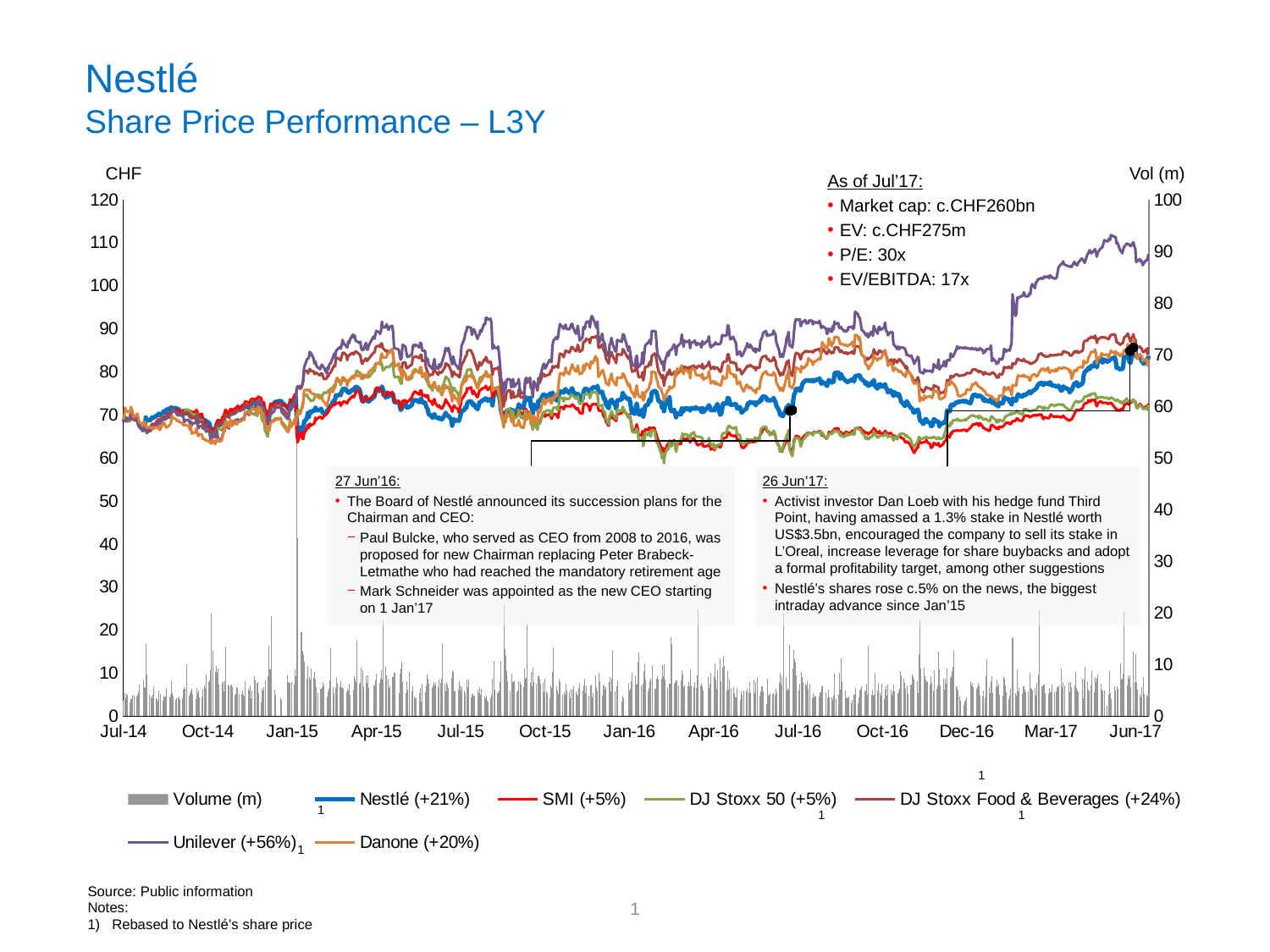
How many series does the legend list? 7 Is the Unilever line at Jun-17 greater or less than 100 on the CHF axis? greater Which series ends highest on the chart at Jun-17? Unilever Which series has the highest percentage change shown in the legend? Unilever (+56%) What percentage change does the legend show for Nestlé? +21% Is the Nestlé line at Jul-14 greater or less than 80 on the CHF axis? less Does the Unilever line rise or fall overall from Jul-14 to Jun-17? rise Which has the larger percentage change in the legend, DJ Stoxx Food & Beverages or Danone? DJ Stoxx Food & Beverages (+24%) What is the difference in percentage points between the legend values for Unilever and Nestlé? 35 percentage points What unit is shown on the left vertical axis of the chart? CHF What kind of chart is shown on the slide? A line chart (with volume bars) What percentage change does the legend show for Unilever? +56%